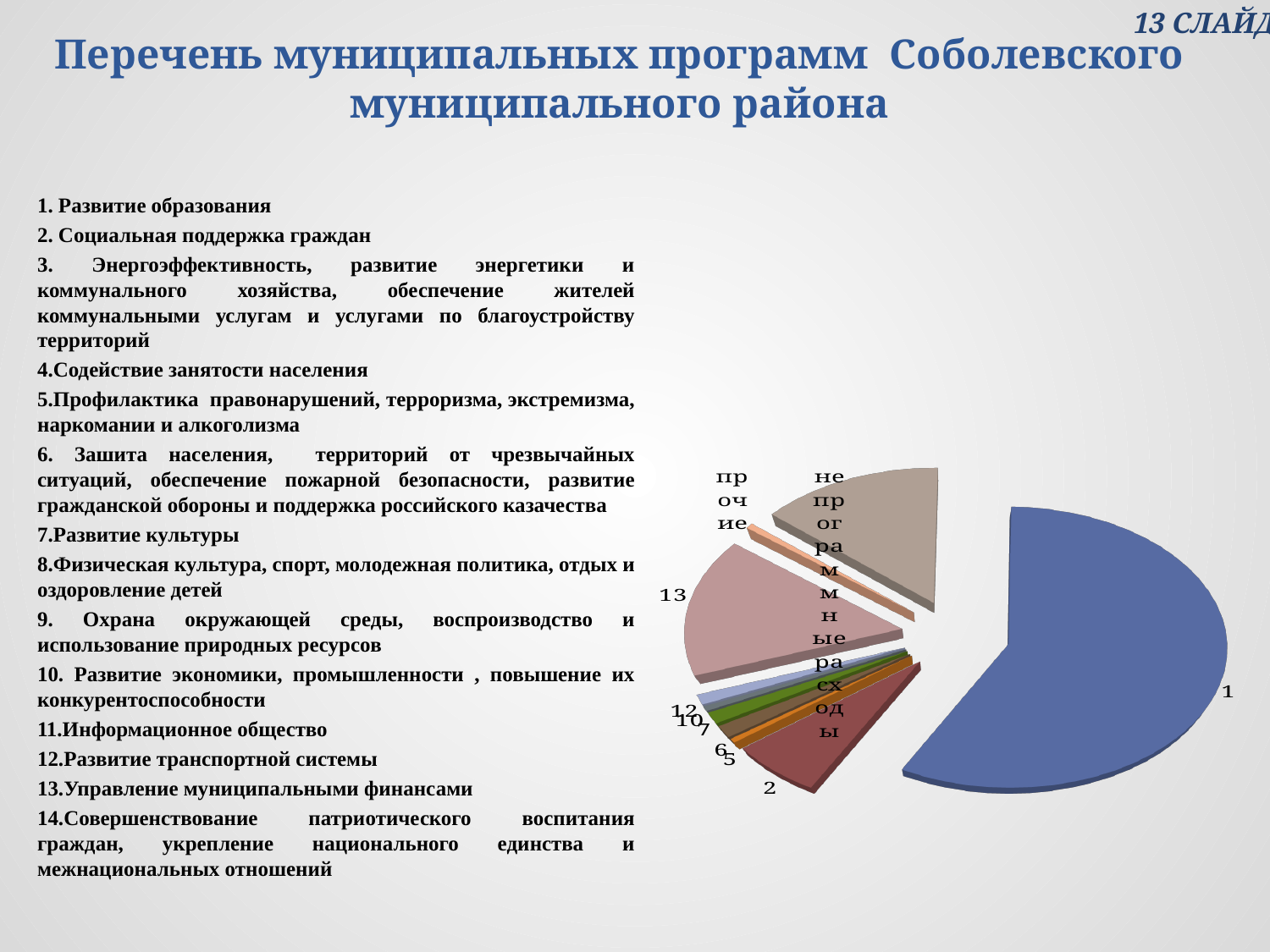
What kind of chart is shown on the slide? pie chart What colour is slice 1 in the pie chart? blue Which is larger in the pie chart, slice 1 or the slice labelled 'непрограммные расходы'? 1 Which is larger in the pie chart, slice 13 or slice 5? 13 Which is larger in the pie chart, slice 2 or slice 6? 2 Which slice of the pie chart is the largest? 1 Which slice of the pie chart is labelled 'прочие'? the thin orange slice next to 'непрограммные расходы'